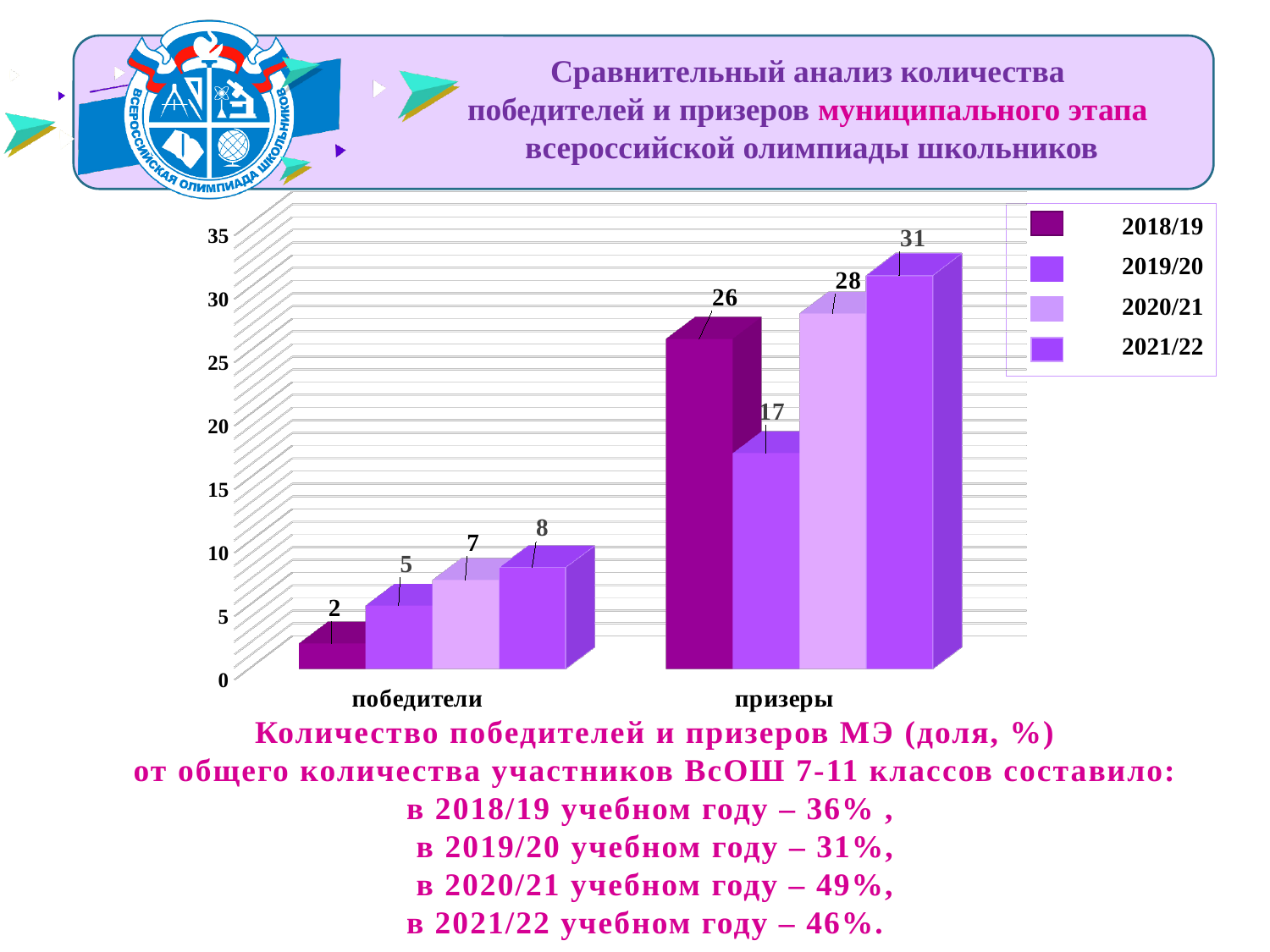
What kind of chart is shown on the slide? bar chart How many series does the legend list? 4 What is the value for призеры in 2021/22? 31 How many categories are shown on the x axis? 2 What is the value for победители in 2018/19? 2 What is the value for призеры in 2019/20? 17 Which is larger: призеры in 2020/21 or призеры in 2018/19? призеры in 2020/21 Do the values for победители rise or fall from 2018/19 to 2021/22? rise Which year has the highest value for призеры? 2021/22 Which year has the lowest value for победители? 2018/19 What is the difference between призеры in 2018/19 and призеры in 2019/20? 9 What is the value for победители in 2020/21? 7